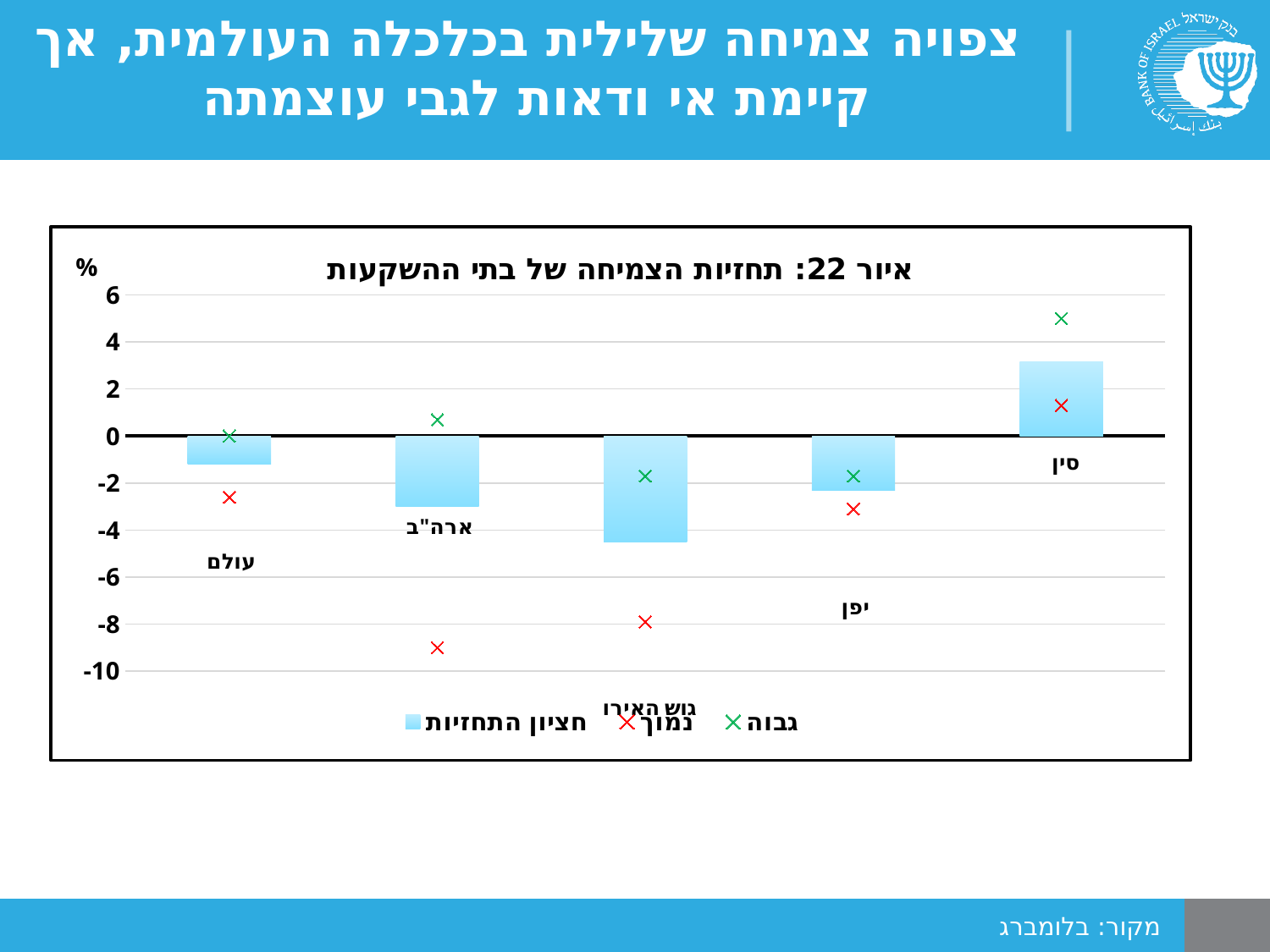
Is the median forecast (חציון התחזיות) for גוש האירו greater or less than -4? less How many categories (regions) are shown on the x axis of the chart? 5 Which category has the highest median forecast (חציון התחזיות) bar? סין Is the median forecast (חציון התחזיות) for עולם greater or less than -2? greater What is the title of the chart? איור 22: תחזיות הצמיחה של בתי ההשקעות Which has the larger median forecast (חציון התחזיות): ארה"ב or יפן? יפן Which category has the lowest median forecast (חציון התחזיות) bar? גוש האירו Is the median forecast (חציון התחזיות) for סין greater or less than 2? greater What kind of chart is shown on the slide? bar chart How many series does the chart's legend list? 3 Which category has the lowest low forecast (נמוך) marker? ארה"ב